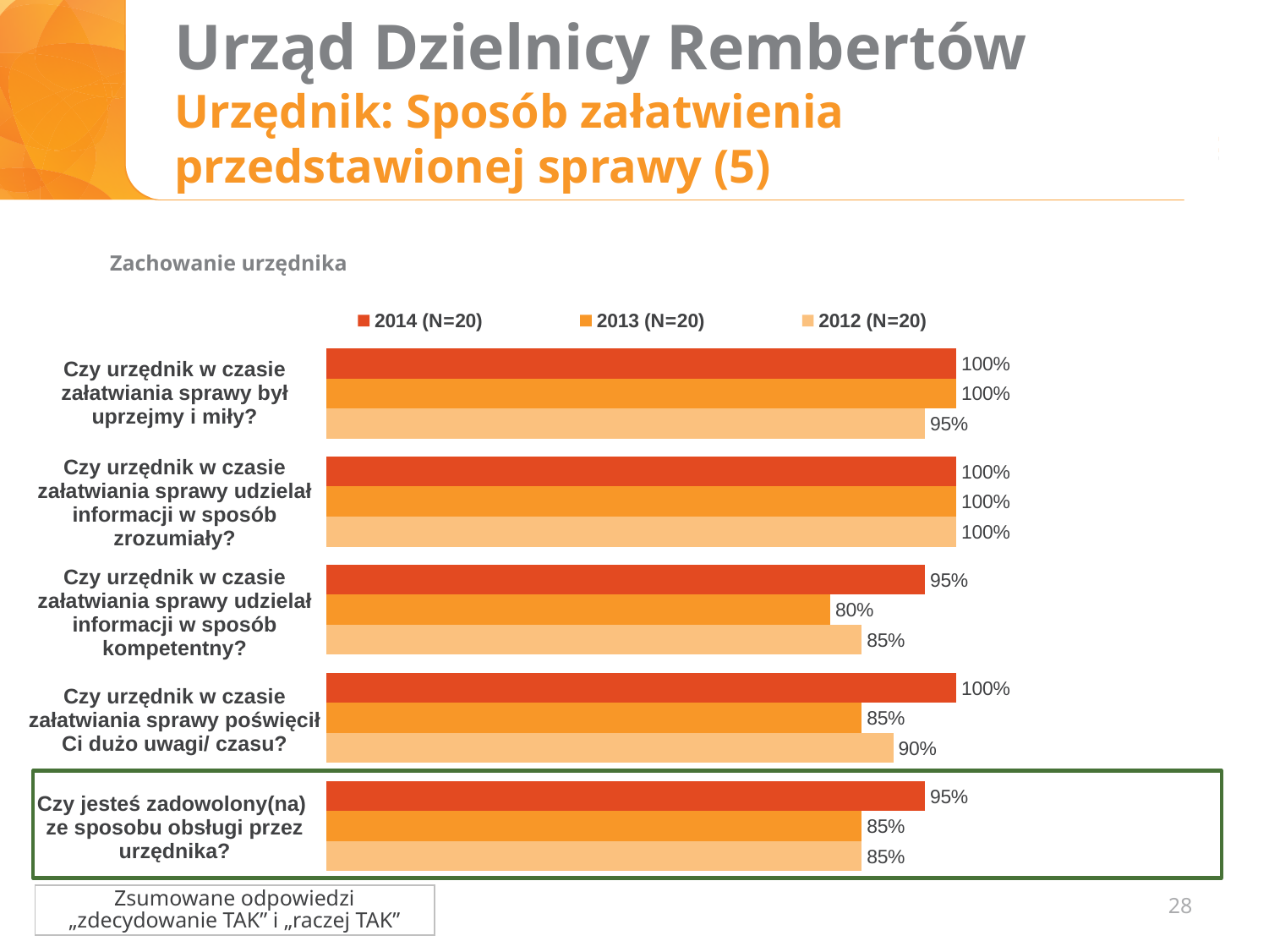
What kind of chart is shown on the slide? bar chart How many question categories are plotted in the chart? 5 What is the title shown above the chart? Zachowanie urzędnika How many series does the legend list? 3 What is the 2013 (N=20) value for "Czy urzędnik w czasie załatwiania sprawy udzielał informacji w sposób kompetentny?"? 80% What is the difference between the 2014 (N=20) and 2013 (N=20) values for "Czy urzędnik w czasie załatwiania sprawy poświęcił Ci dużo uwagi/ czasu?"? 15% What is the difference between the 2012 (N=20) and 2013 (N=20) values for "Czy urzędnik w czasie załatwiania sprawy udzielał informacji w sposób kompetentny?"? 5% What is the 2012 (N=20) value for "Czy urzędnik w czasie załatwiania sprawy był uprzejmy i miły?"? 95% Which question has the lowest 2013 (N=20) value? Czy urzędnik w czasie załatwiania sprawy udzielał informacji w sposób kompetentny? For "Czy jesteś zadowolony(na) ze sposobu obsługi przez urzędnika?", which is larger: the 2014 (N=20) value or the 2012 (N=20) value? 2014 (N=20) What is the 2014 (N=20) value for "Czy urzędnik w czasie załatwiania sprawy udzielał informacji w sposób kompetentny?"? 95% What is the 2013 (N=20) value for "Czy urzędnik w czasie załatwiania sprawy poświęcił Ci dużo uwagi/ czasu?"? 85%